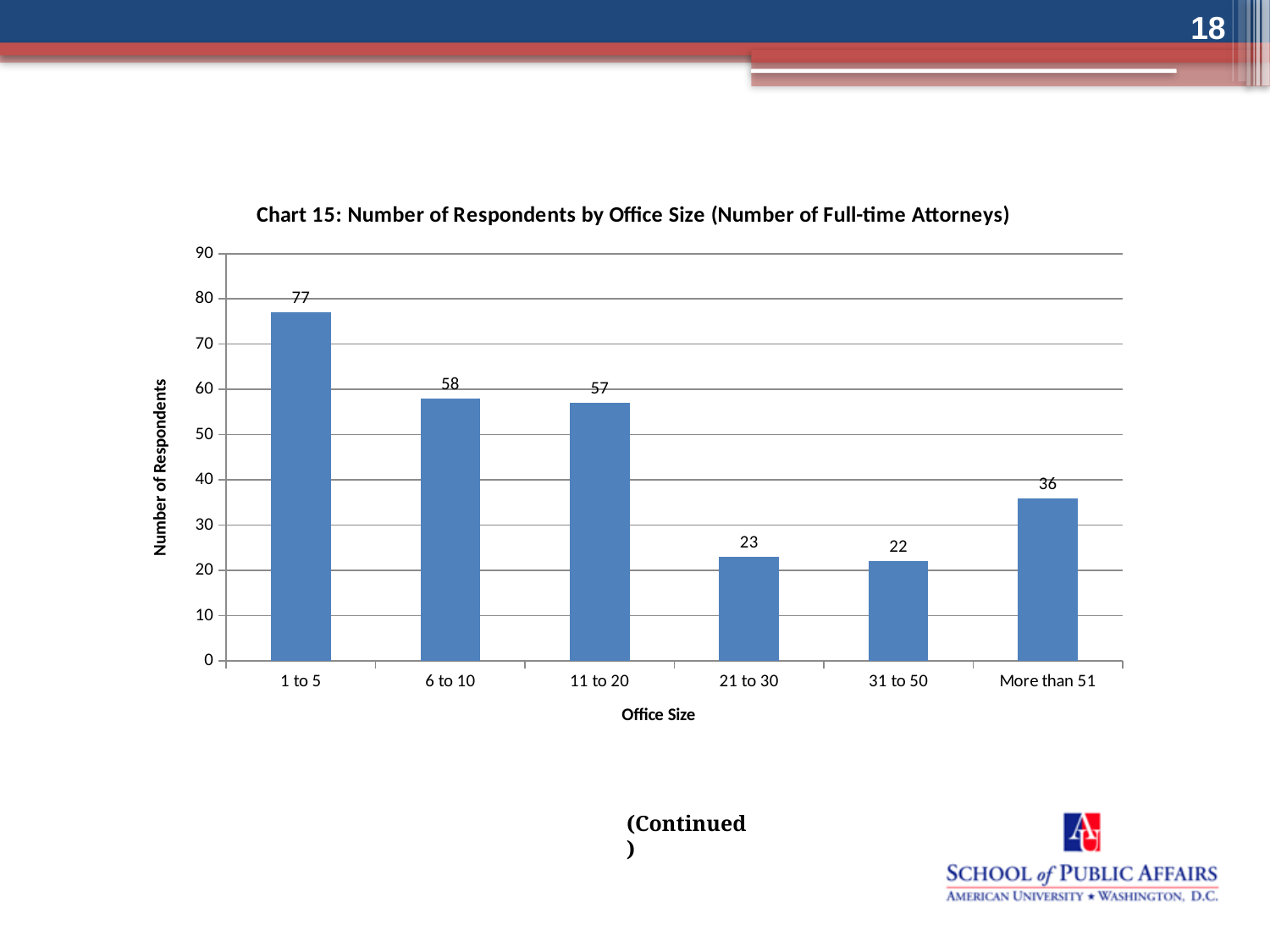
What is the difference in number of respondents between the 1 to 5 and 6 to 10 office sizes? 19 How many respondents are in the 1 to 5 office size category? 77 Which office size category has the highest number of respondents? 1 to 5 Is the number of respondents for the 21 to 30 office size greater or less than 30? less Which office size category has the lowest number of respondents? 31 to 50 What is the difference in number of respondents between the More than 51 and 21 to 30 office sizes? 13 What type of chart is shown on the slide? bar chart How many office size categories are shown on the chart? 6 Which has more respondents, the 11 to 20 office size or the More than 51 office size? 11 to 20 What is the number of respondents for the 6 to 10 office size? 58 What is the number of respondents for the More than 51 office size? 36 What is the title of the chart? Chart 15: Number of Respondents by Office Size (Number of Full-time Attorneys)